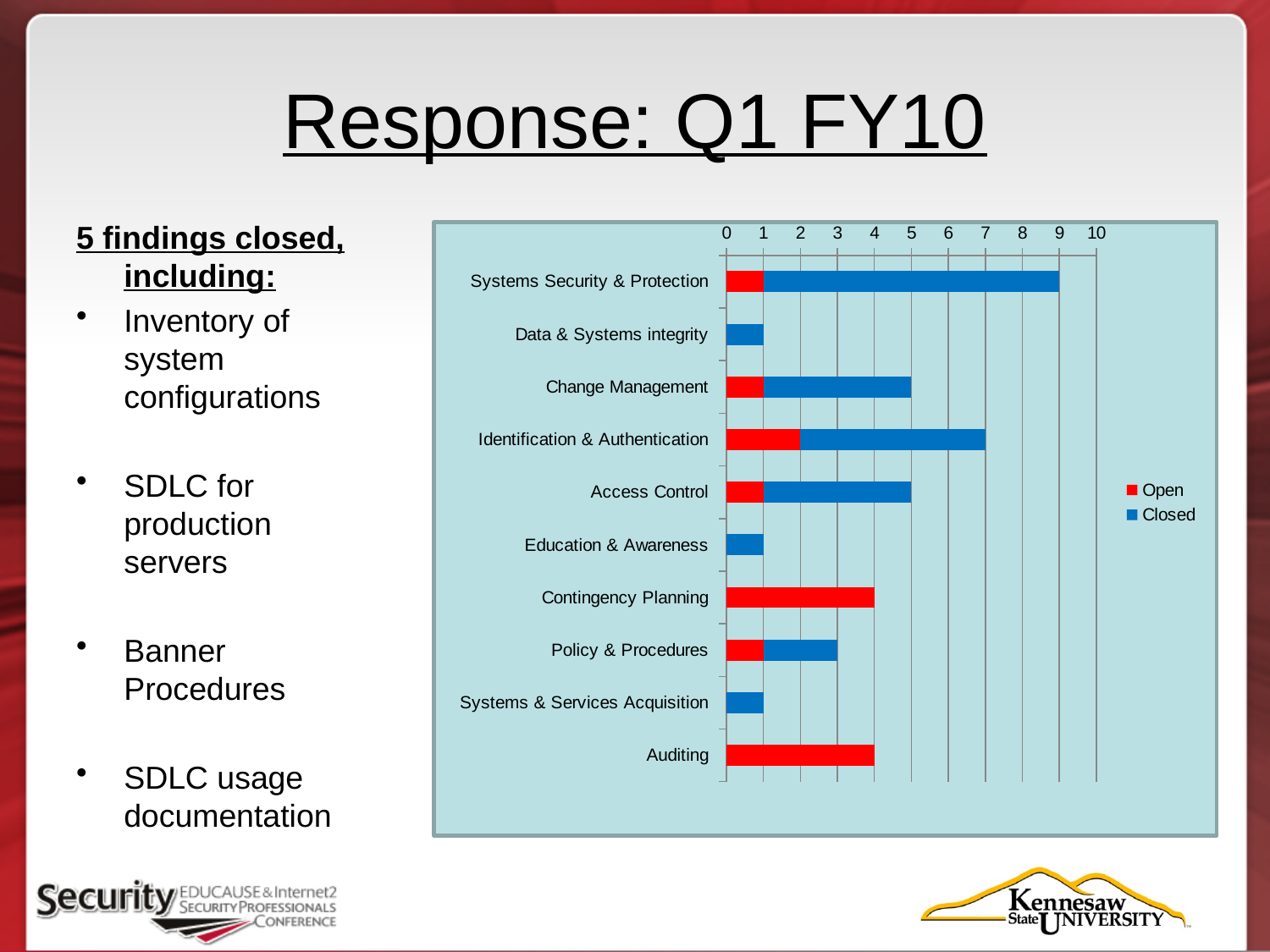
What is the total length of the bar for Identification & Authentication? 7 Which colour represents the Open series in the chart? Red Which category has the longest total bar? Systems Security & Protection How many series does the chart legend list? 2 What is the total length of the bar for Systems Security & Protection? 9 How many categories are plotted on the chart? 10 What is the difference between the total bar lengths for Systems Security & Protection and Identification & Authentication? 2 What is the Closed value for Data & Systems integrity? 1 What kind of chart is shown on the slide? Stacked bar chart What is the Open value for Identification & Authentication? 2 What is the Open value for Contingency Planning? 4 Which has a longer total bar, Identification & Authentication or Change Management? Identification & Authentication